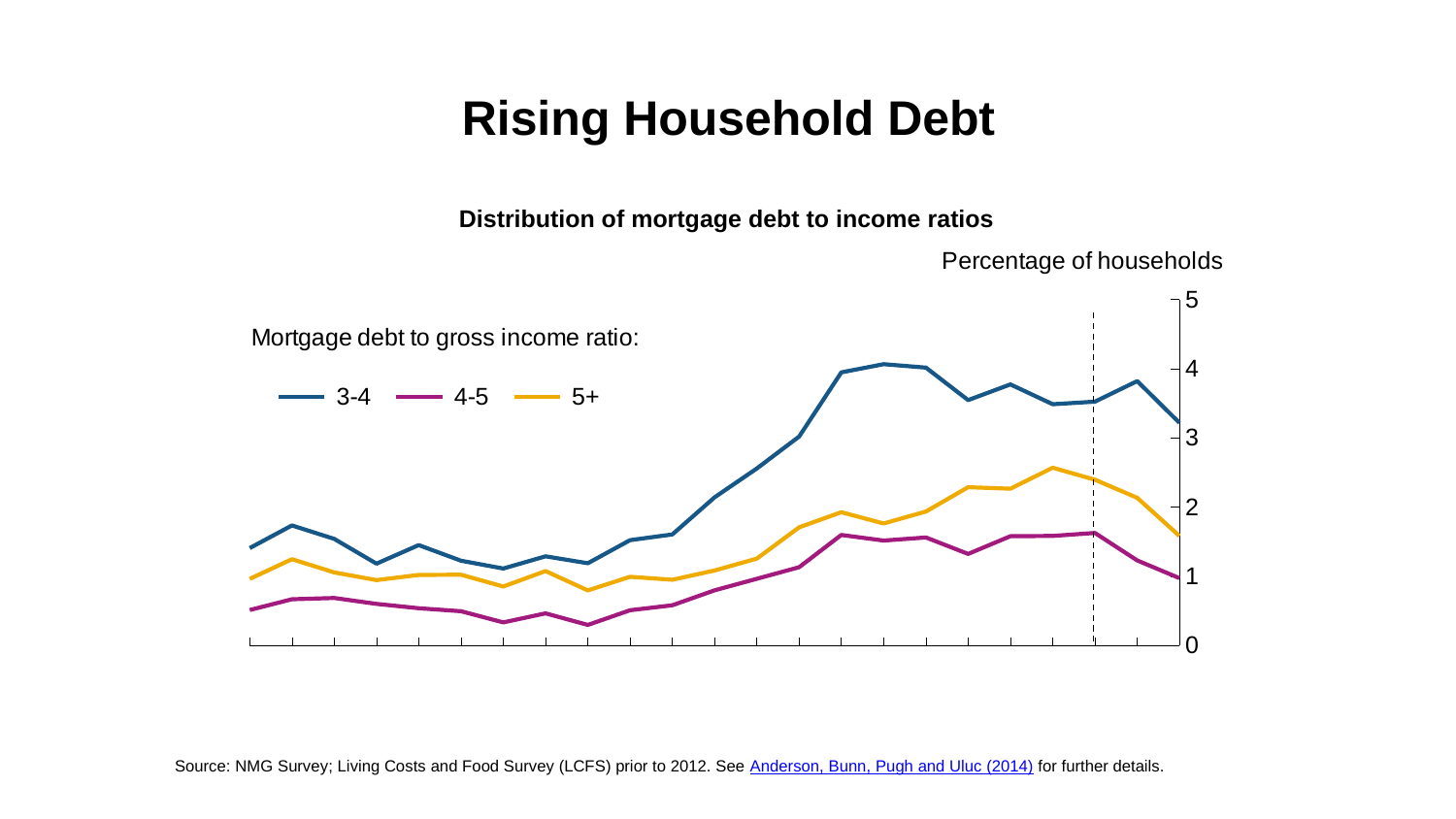
What kind of chart is shown on the slide? line chart Overall, do the values of the 3-4 series rise or fall from the left of the chart to the right? rise Is the peak value of the 5+ series greater or less than 2? greater At the right-hand end of the chart, which series is larger, 5+ or 4-5? 5+ Is the value of the 3-4 series at the right-hand end of the chart greater or less than 3? greater Is the value of the 4-5 series at the left-hand start of the chart greater or less than 1? less How many series does the legend list? 3 Which series has the highest values across the whole chart? 3-4 What is the title of the chart? Distribution of mortgage debt to income ratios What are the three mortgage debt to gross income ratio categories listed in the legend? 3-4, 4-5, 5+ Which series has the lowest values across the whole chart? 4-5